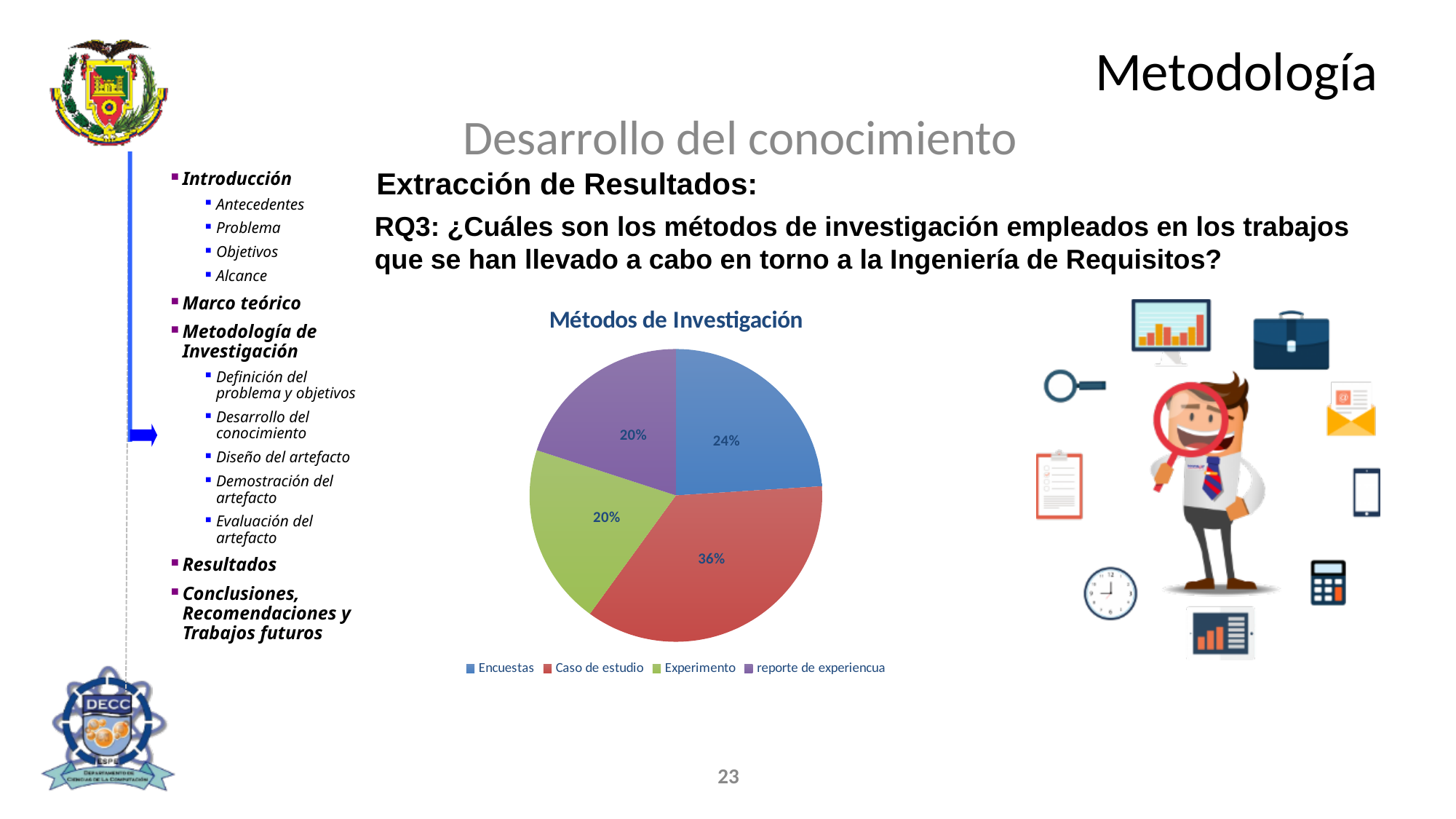
Which research method has the largest share of the pie? Caso de estudio What percentage of the pie does "Experimento" represent? 20% What is the difference in percentage points between "Caso de estudio" and "Encuestas"? 12 What percentage of the pie does "Encuestas" represent? 24% What percentage of the pie does "Caso de estudio" represent? 36% What is the combined share of "Experimento" and "reporte de experiencua"? 40% What type of chart is shown under the title "Métodos de Investigación"? pie chart How many slices does the pie chart have? 4 What is the title of the chart? Métodos de Investigación Which is larger, the share for "Encuestas" or the share for "Experimento"? Encuestas How many entries does the legend list? 4 What colour is the "Caso de estudio" slice? red